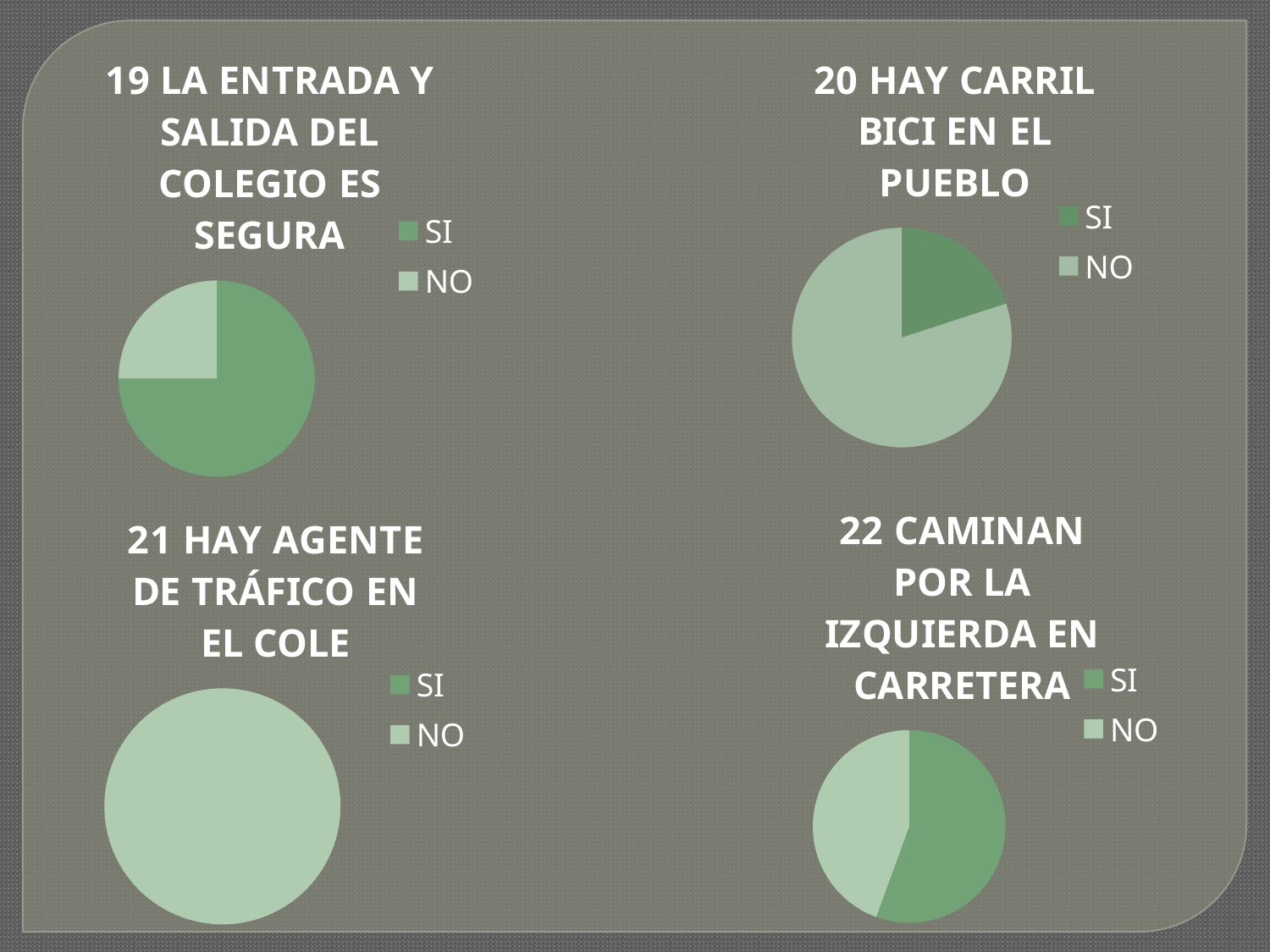
What is the title of the pie chart in the bottom-right of the slide? 22 CAMINAN POR LA IZQUIERDA EN CARRETERA What are the two legend entries in the chart "21 HAY AGENTE DE TRÁFICO EN EL COLE"? SI and NO In the chart "21 HAY AGENTE DE TRÁFICO EN EL COLE", which category takes up the whole pie? NO In the chart "19 LA ENTRADA Y SALIDA DEL COLEGIO ES SEGURA", which category has the smallest slice? NO In the chart "20 HAY CARRIL BICI EN EL PUEBLO", which category has the smallest slice? SI How many pie charts are shown on the slide? 4 In the chart "19 LA ENTRADA Y SALIDA DEL COLEGIO ES SEGURA", which slice is larger, SI or NO? SI What kind of chart is used for "19 LA ENTRADA Y SALIDA DEL COLEGIO ES SEGURA"? Pie chart In the chart "22 CAMINAN POR LA IZQUIERDA EN CARRETERA", which slice is larger, SI or NO? SI How many entries does the legend of the chart "20 HAY CARRIL BICI EN EL PUEBLO" list? 2 In the chart "20 HAY CARRIL BICI EN EL PUEBLO", which category has the largest slice? NO